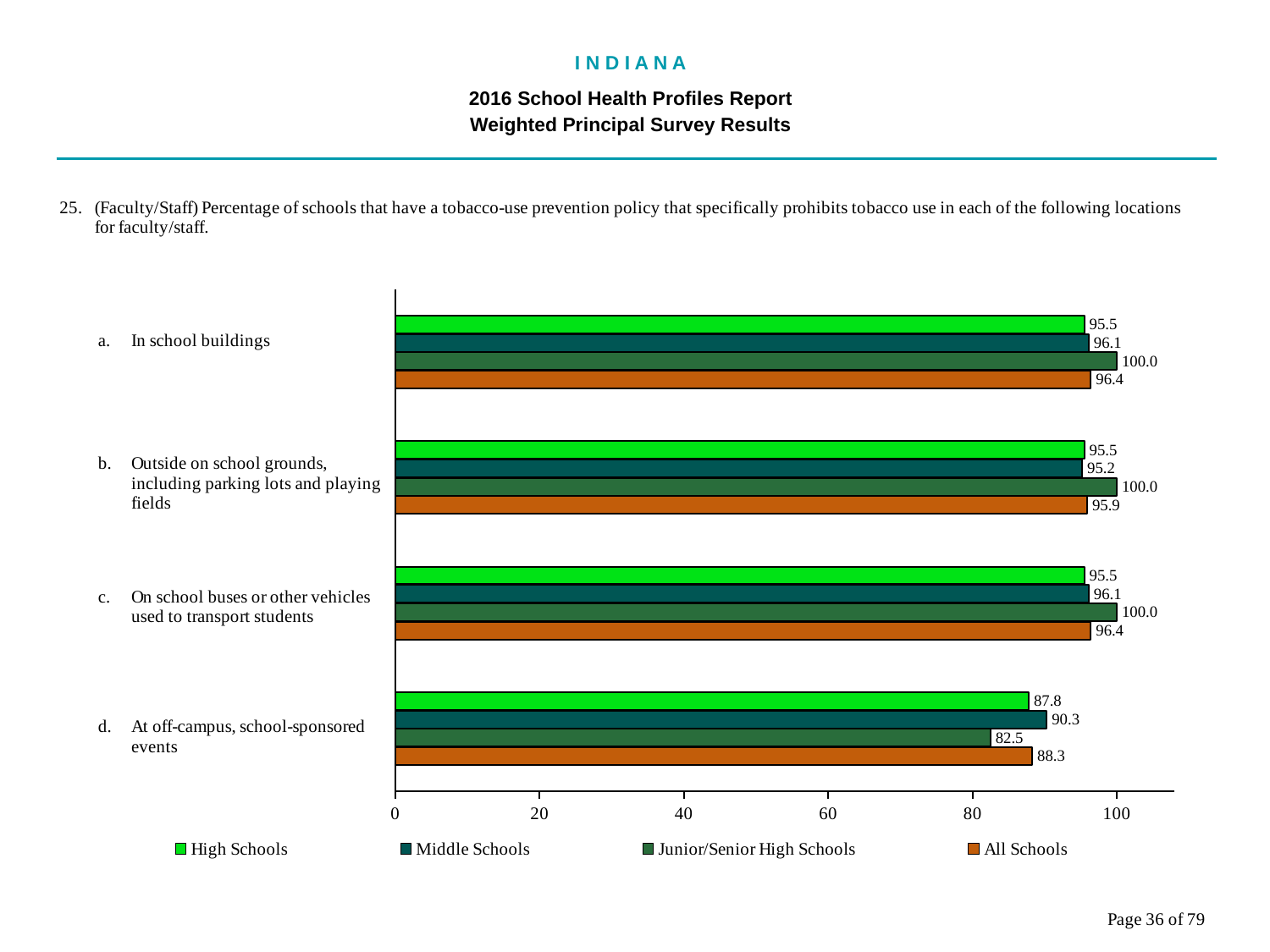
Which series has the highest value for 'Outside on school grounds, including parking lots and playing fields'? Junior/Senior High Schools What is the value for High Schools for 'On school buses or other vehicles used to transport students'? 95.5 Which is larger for 'At off-campus, school-sponsored events': the High Schools value or the All Schools value? All Schools How many location categories are shown on the chart? 4 What kind of chart is shown on the slide? bar chart What is the value for All Schools for 'Outside on school grounds, including parking lots and playing fields'? 95.9 What is the difference between the Middle Schools and Junior/Senior High Schools values for 'At off-campus, school-sponsored events'? 7.8 Which series has the lowest value for 'At off-campus, school-sponsored events'? Junior/Senior High Schools Is the Junior/Senior High Schools value for 'At off-campus, school-sponsored events' greater or less than 80? greater What is the value for Middle Schools for 'At off-campus, school-sponsored events'? 90.3 How many series does the legend list? 4 What is the value for Junior/Senior High Schools for 'In school buildings'? 100.0